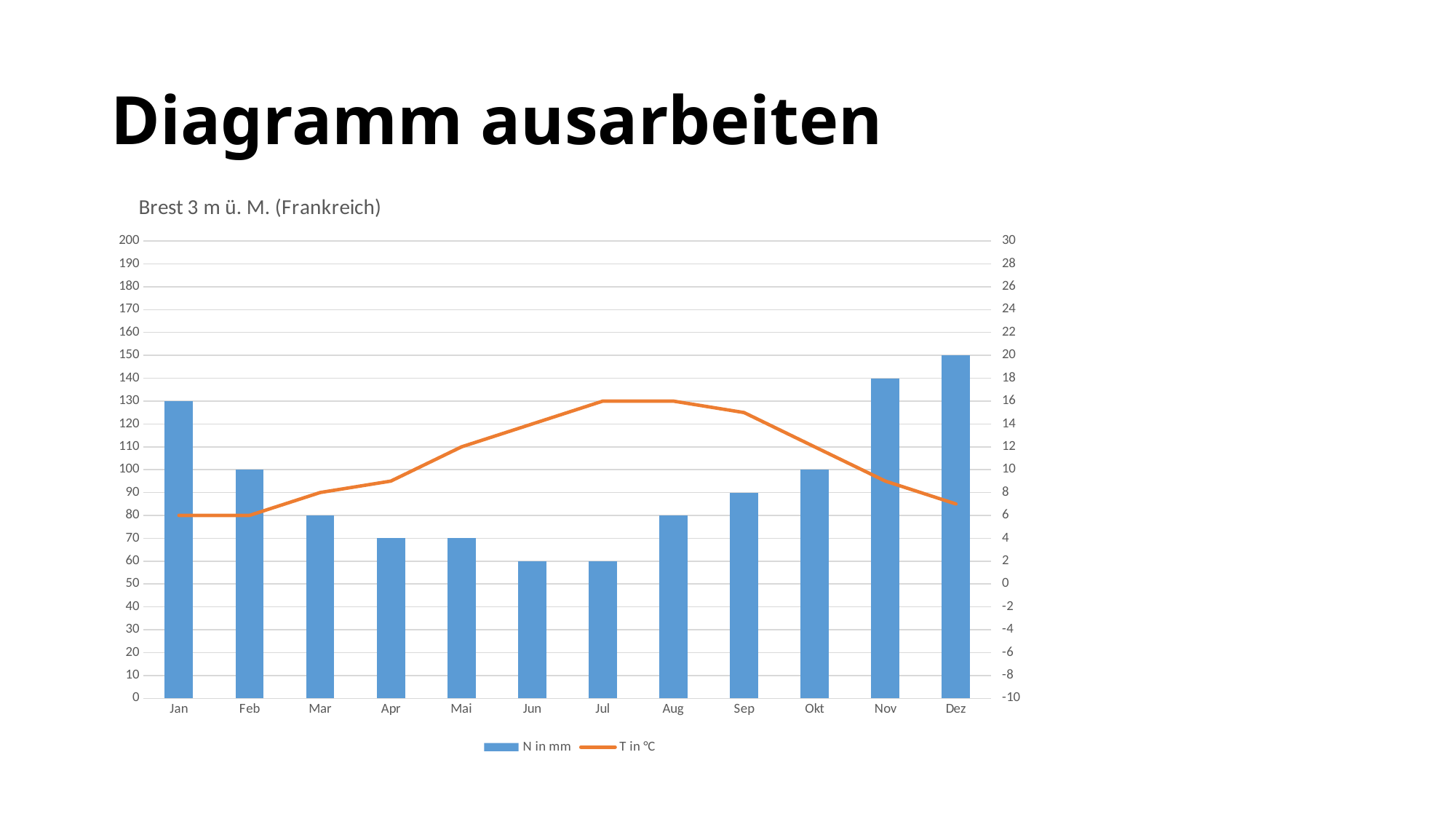
What is the value of N in mm for Jan? 130 How many months are shown on the x axis? 12 Do the N in mm values rise or fall from Aug to Dez? rise What is the value of N in mm for Dez? 150 What is the value of T in °C for Jul? 16 What is the difference in N in mm between Dez and Jan? 20 Which month has the highest N in mm? Dez What kind of chart is shown on the slide? A combined bar and line chart What is the title of the chart? Brest 3 m ü. M. (Frankreich) Which month has a higher N in mm, Nov or Okt? Nov How many series does the legend list? 2 Is the value of T in °C for Sep greater or less than 10? greater